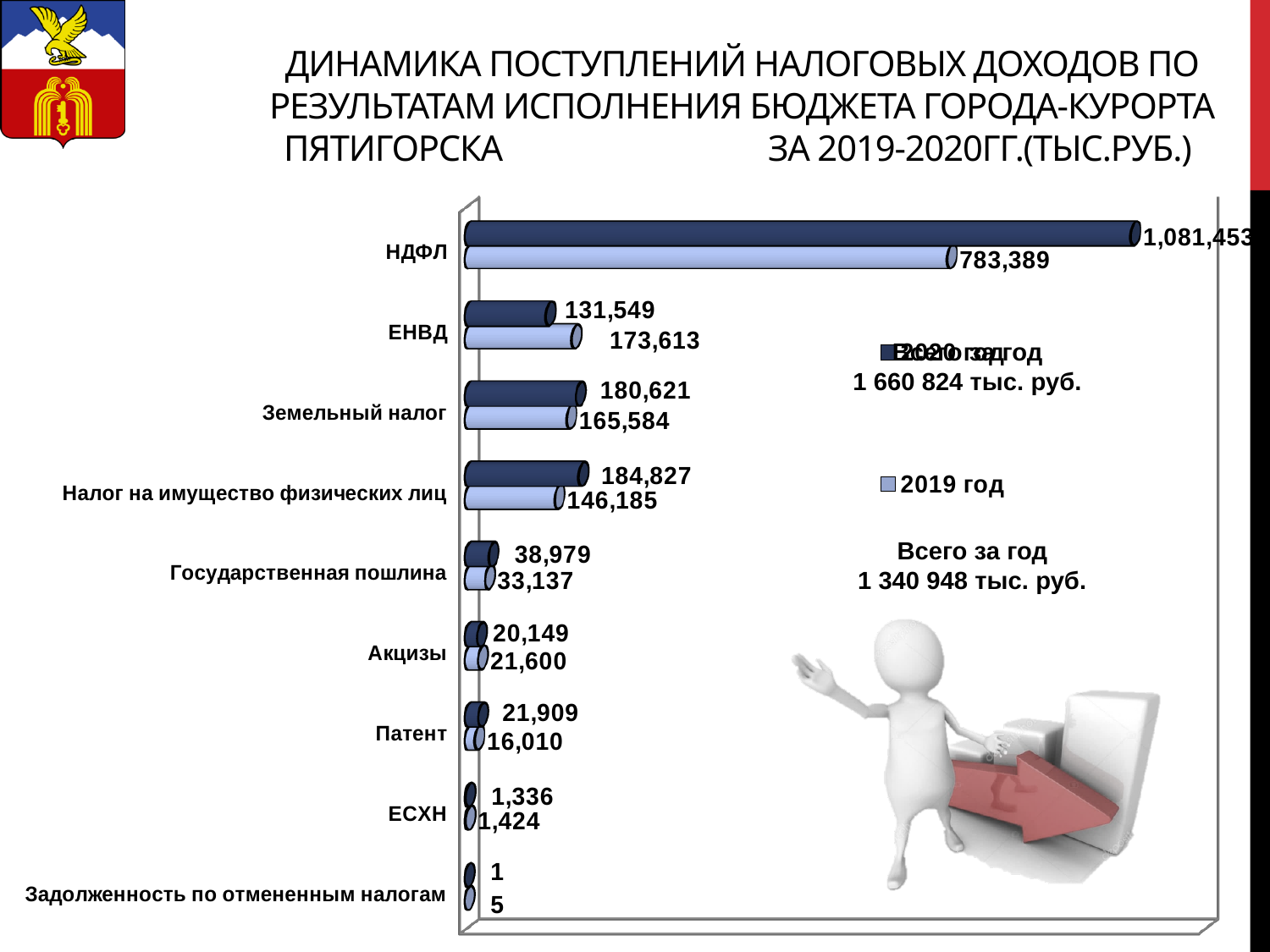
What total for 2019 год is stated next to the legend? 1 340 948 тыс. руб. What kind of chart is shown on the slide? bar chart What is the value for Патент in the 2020 год series? 21,909 What is the value for НДФЛ in the 2020 год series? 1,081,453 How many categories are plotted on the chart? 9 Which is larger for ЕНВД: the 2020 год value or the 2019 год value? 2019 год What is the difference between the 2020 год and 2019 год values for Налог на имущество физических лиц? 38,642 What is the value for ЕНВД in the 2019 год series? 173,613 Which category has the highest value in the 2020 год series? НДФЛ How many series does the legend list? 2 Which category has the lowest value in the 2019 год series? Задолженность по отмененным налогам Which is larger for Государственная пошлина: the 2020 год value or the 2019 год value? 2020 год